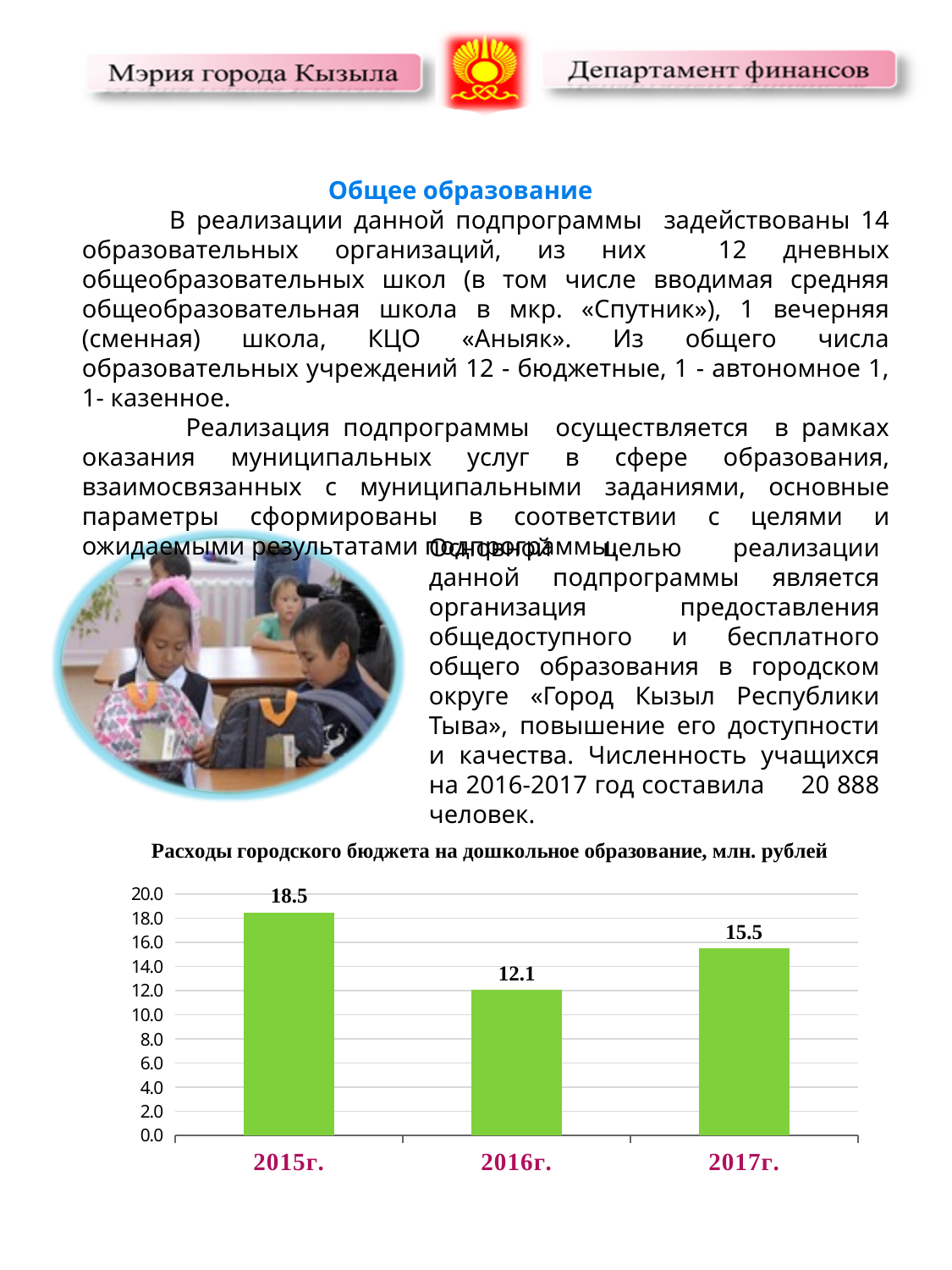
Which year has the lowest value? 2016г. What is the value for 2015г.? 18.5 Is the value for 2016г. greater or less than 14.0? less What is the title of the chart? Расходы городского бюджета на дошкольное образование, млн. рублей What is the difference between the values for 2015г. and 2016г.? 6.4 What is the value for 2016г.? 12.1 How many years are shown on the chart? 3 Which is larger, the value for 2015г. or the value for 2017г.? 2015г. Which year has the highest value? 2015г. What is the difference between the values for 2017г. and 2016г.? 3.4 What is the value for 2017г.? 15.5 What kind of chart is shown on the slide? bar chart